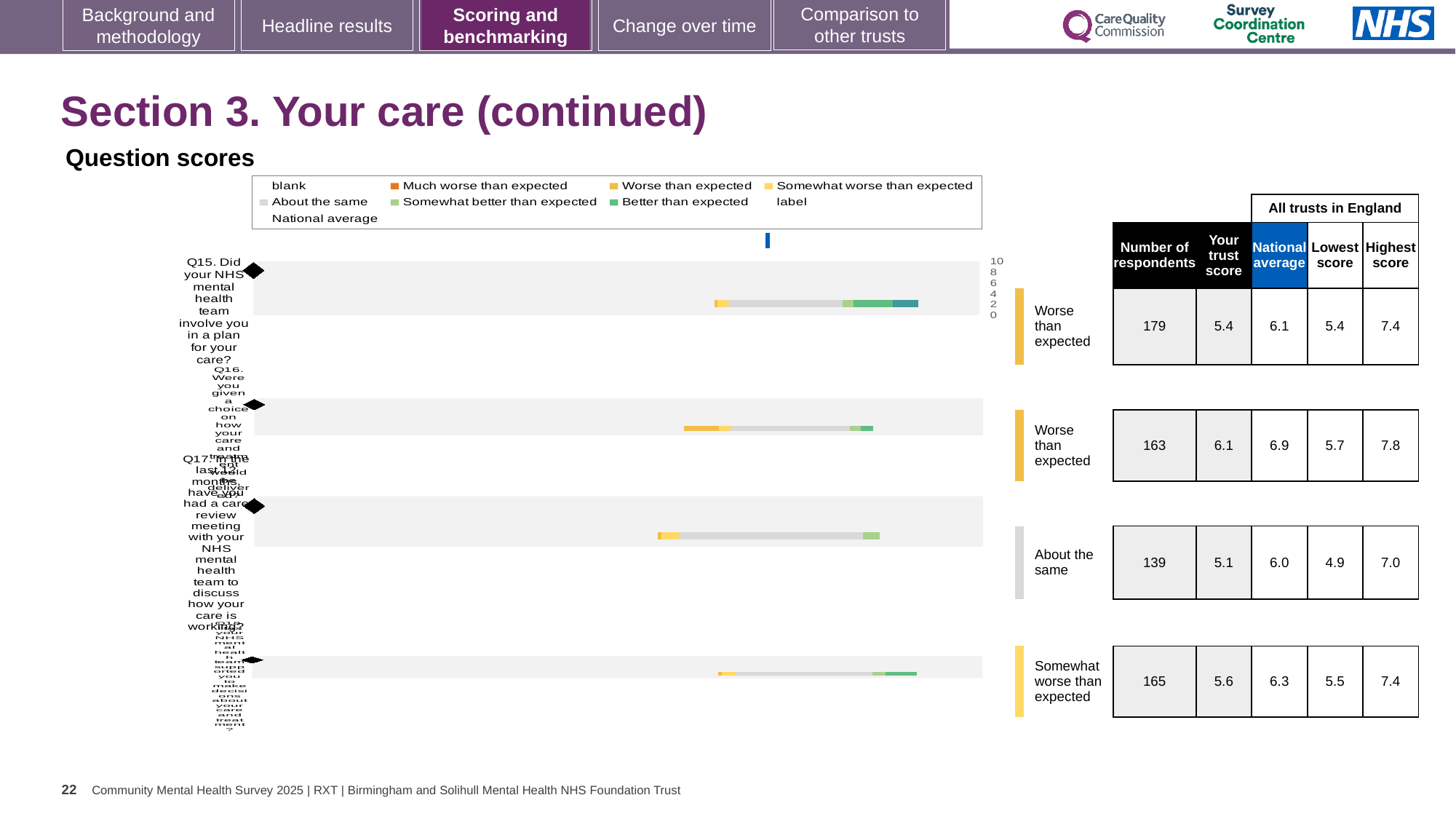
Which question row has the highest 'Your trust score'? Q16 How many question rows are plotted in the chart? 4 What kind of chart is shown under 'Question scores'? bar chart What is the national average score for Q15? 6.1 What is the highest score among all trusts in England for Q16? 7.8 What benchmark category is shown for Q17? About the same For Q15, which is larger: the trust score or the national average? National average What is the difference between the national average and the trust score for Q16? 0.8 What is the difference between the highest and lowest scores for Q17? 2.1 Which question row has the lowest number of respondents? Q17 What is the 'Your trust score' for Q15 (Did your NHS mental health team involve you in a plan for your care?)? 5.4 How many respondents answered Q17 (care review meeting with your NHS mental health team)? 139